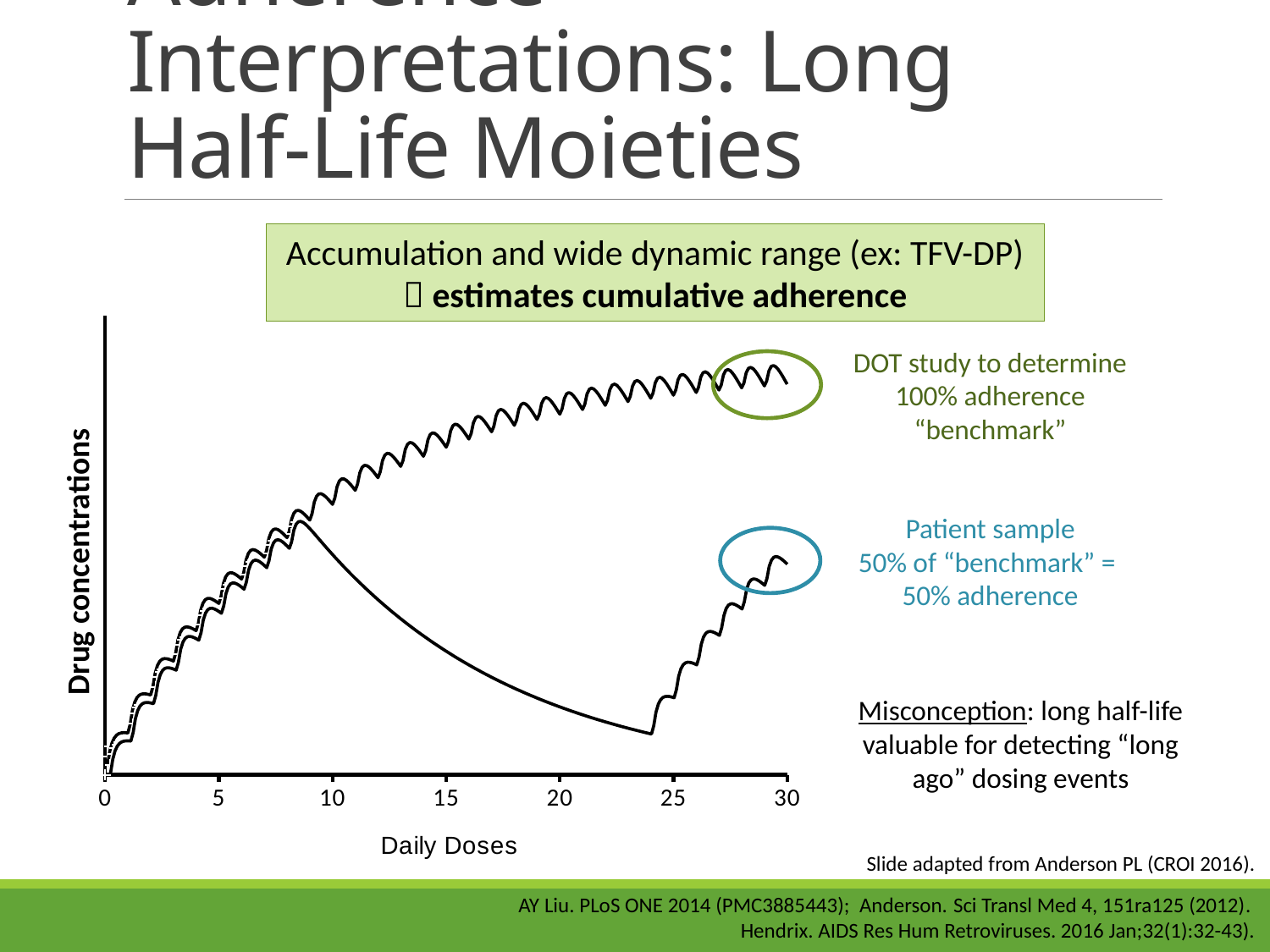
Between 10 and 20 daily doses, does the lower curve rise or fall? fall Does the lower curve begin to decline before or after 10 daily doses? before What is the label of the y axis of the chart? Drug concentrations What is the label of the x axis of the chart? Daily Doses Does the upper curve rise or fall as daily doses increase from 0 to 30? rise What is the highest tick value shown on the x axis? 30 Does the lower curve reach its minimum before or after 20 daily doses? after How many tick values are labelled on the x axis? 7 How many curves are plotted on the chart? 2 At 30 daily doses, which curve has the higher drug concentration, the upper continuous-dosing curve or the lower interrupted-dosing curve? the upper continuous-dosing curve What kind of chart is shown on the slide? line chart Between 25 and 30 daily doses, does the lower curve rise or fall? rise